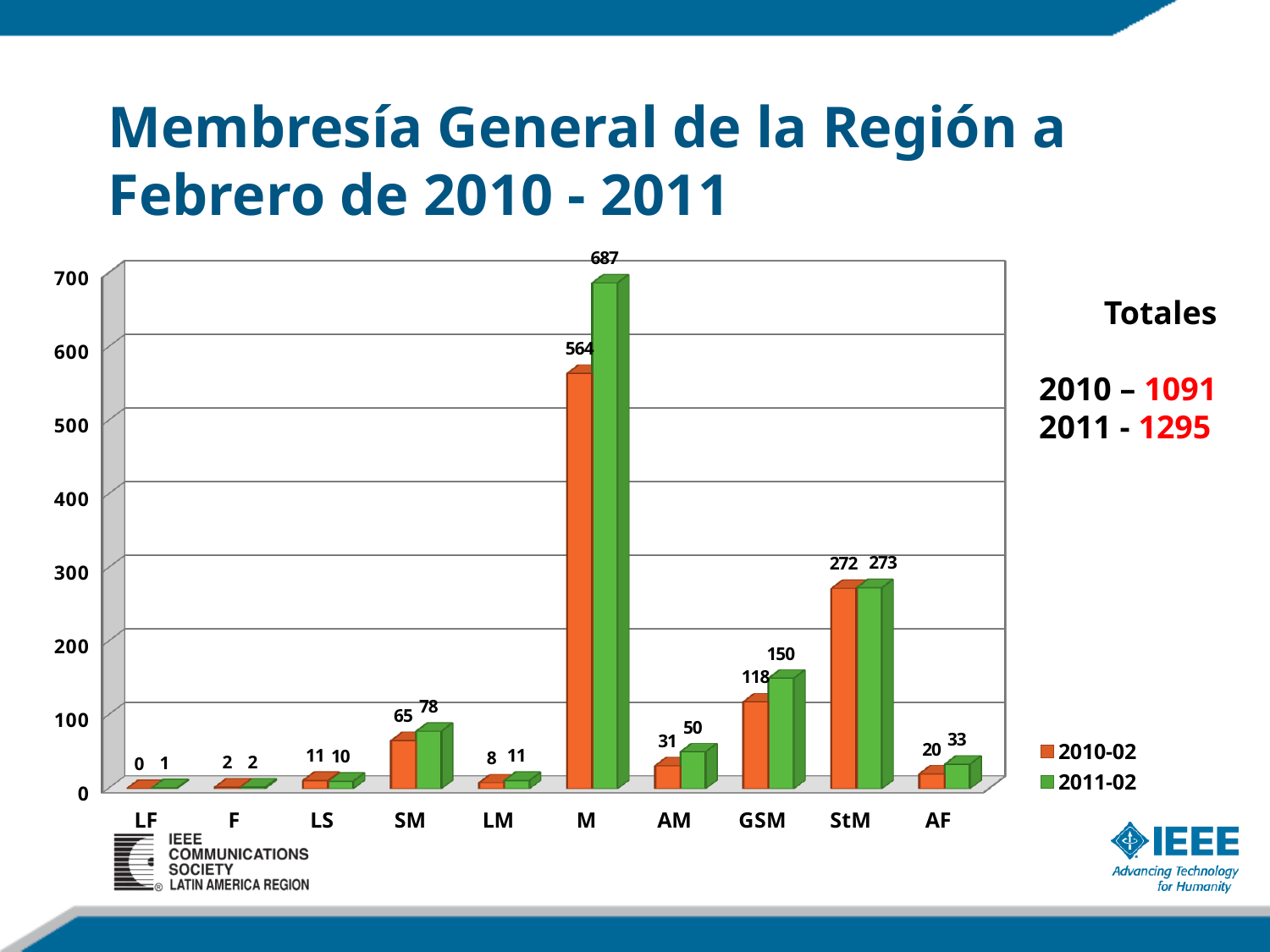
What is the difference between the 2011-02 and 2010-02 values for GSM? 32 What total is given for 2011 in the 'Totales' text on the slide? 1295 What is the value for M in the 2011-02 series? 687 What is the difference between the 2011-02 and 2010-02 values for M? 123 What kind of chart is shown on the slide? Bar chart Which category has the lowest value in the 2011-02 series? LF Which is larger for LS: the 2010-02 value or the 2011-02 value? 2010-02 What is the value for GSM in the 2010-02 series? 118 How many categories are shown on the x axis? 10 Which category has the highest value in the 2010-02 series? M How many series does the legend list? 2 What is the value for SM in the 2011-02 series? 78